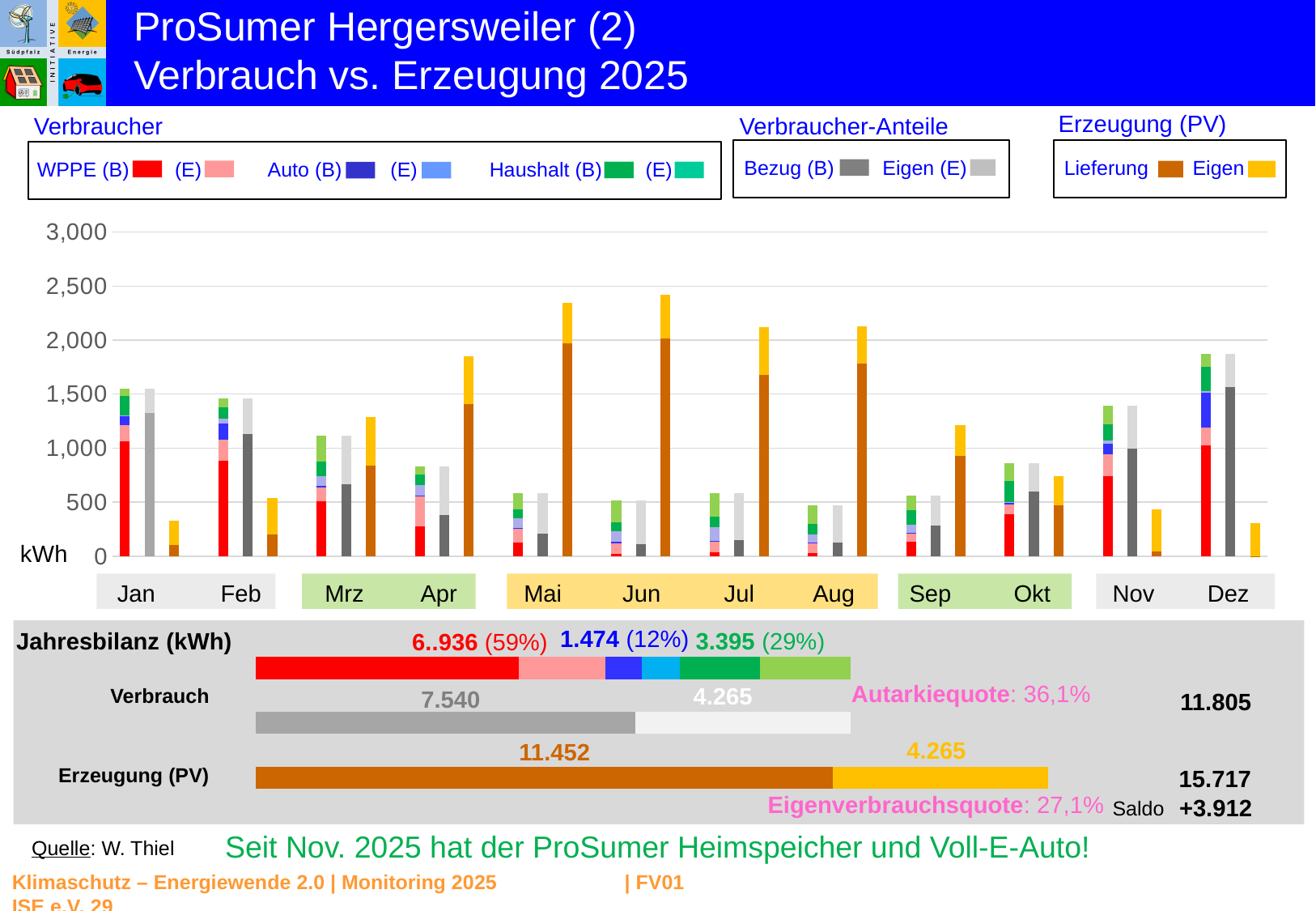
What kind of chart is used to show the monthly values for Verbrauch and Erzeugung? bar chart What is the difference between the annual Erzeugung (PV) of 15.717 kWh and the annual Verbrauch of 11.805 kWh? 3.912 How many months are shown along the x axis of the chart? 12 Is the consumption bar (WPPE/Auto/Haushalt) for Apr greater or less than 1,000 kWh? less What unit is shown on the y axis of the chart? kWh In the Jahresbilanz, what is the total Erzeugung (PV) in kWh? 15.717 What is the highest value shown on the y axis of the chart? 3,000 Is the PV generation bar for Jun greater or less than 2,000 kWh? greater How many entries does the Erzeugung (PV) legend list? 2 Is the Bezug/Eigen bar for Jan greater or less than 1,000 kWh? greater In the Jahresbilanz, what is the total Verbrauch in kWh? 11.805